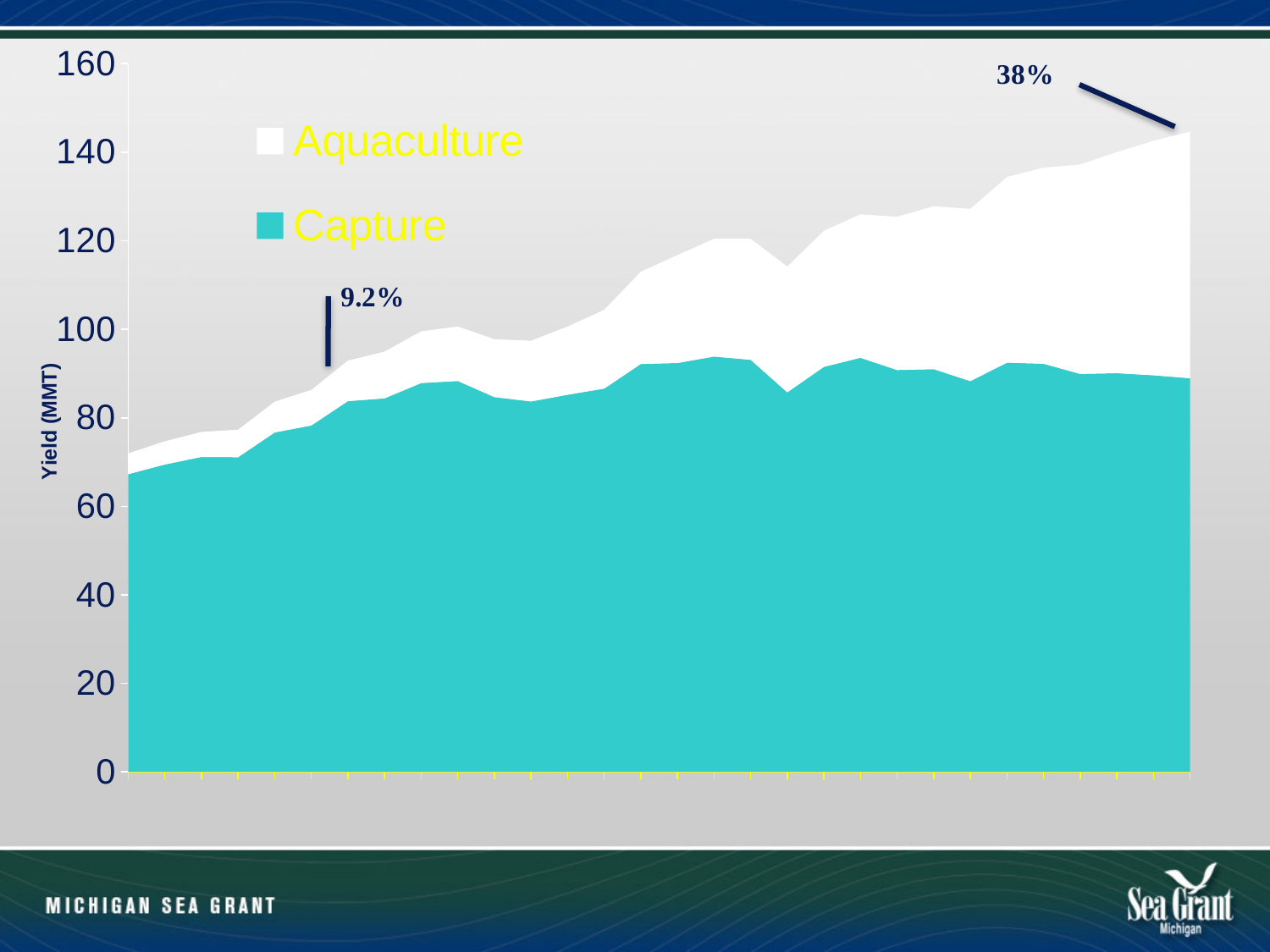
What kind of chart is shown on the slide? area chart Is the Capture value at the left end of the chart greater or less than 60? greater What percentage is annotated near the right end of the chart? 38% How many series does the legend list? 2 Which series is drawn in teal? Capture Is the total stacked value at the right end of the chart greater or less than 140? greater Does the total yield (Capture plus Aquaculture) rise or fall from left to right across the chart? rise What percentage is annotated near the left part of the chart? 9.2% What are the two series named in the legend? Aquaculture and Capture What is the label on the vertical axis? Yield (MMT) Is the total stacked value at the left end of the chart greater or less than 80? less